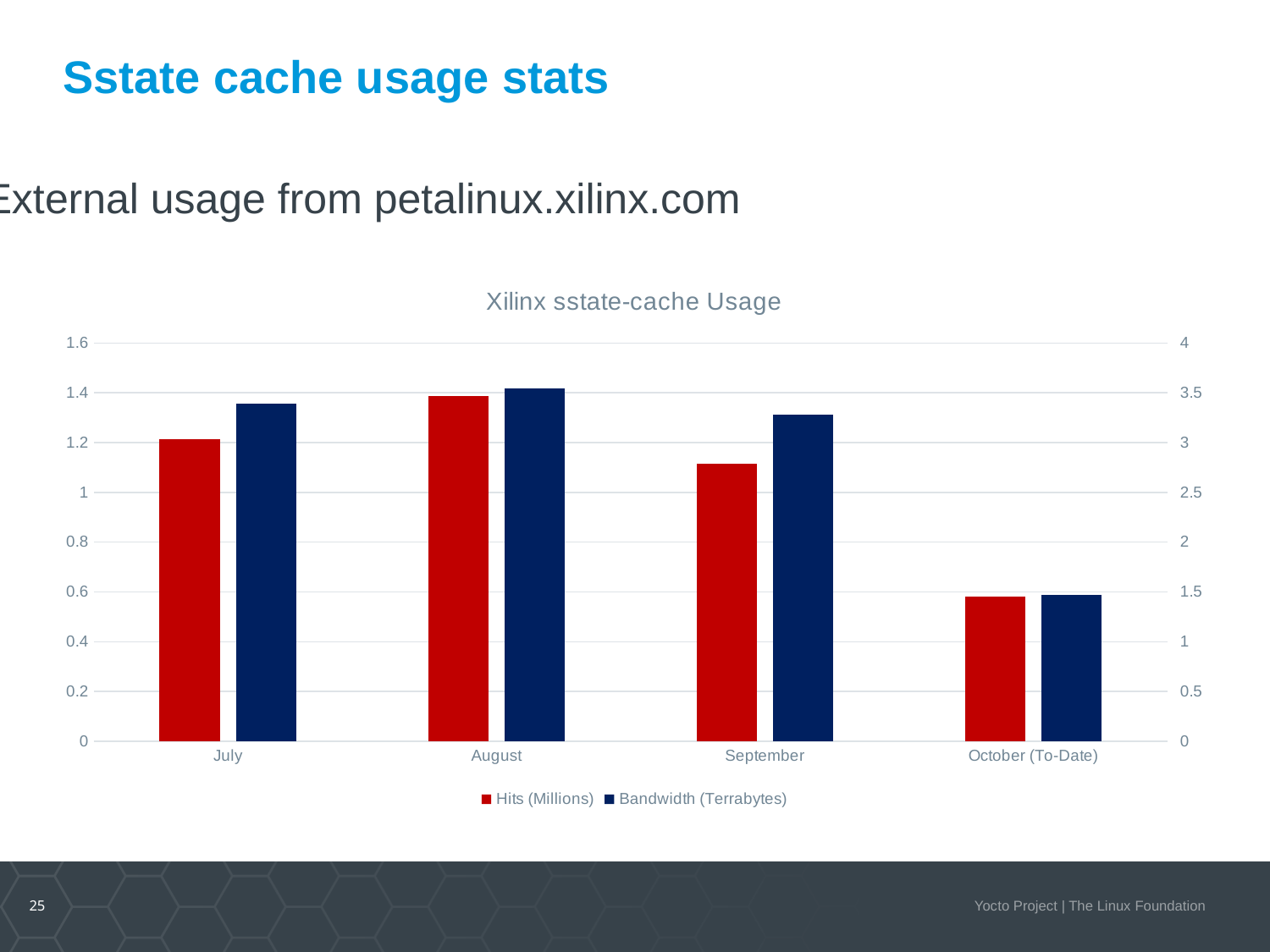
Is the Hits (Millions) value for October (To-Date) greater or less than 0.8? less Which month has the lowest value for Hits (Millions)? October (To-Date) Which is larger, the Hits (Millions) value for July or for September? July How many months (categories) are shown on the x axis? 4 Which month has the highest value for Hits (Millions)? August What is the title of the chart? Xilinx sstate-cache Usage Is the Bandwidth (Terrabytes) value for August greater or less than 3? greater Which month has the lowest value for Bandwidth (Terrabytes)? October (To-Date) Is the Bandwidth (Terrabytes) value for October (To-Date) greater or less than 2? less What kind of chart is shown on the slide? bar chart How many series does the legend list? 2